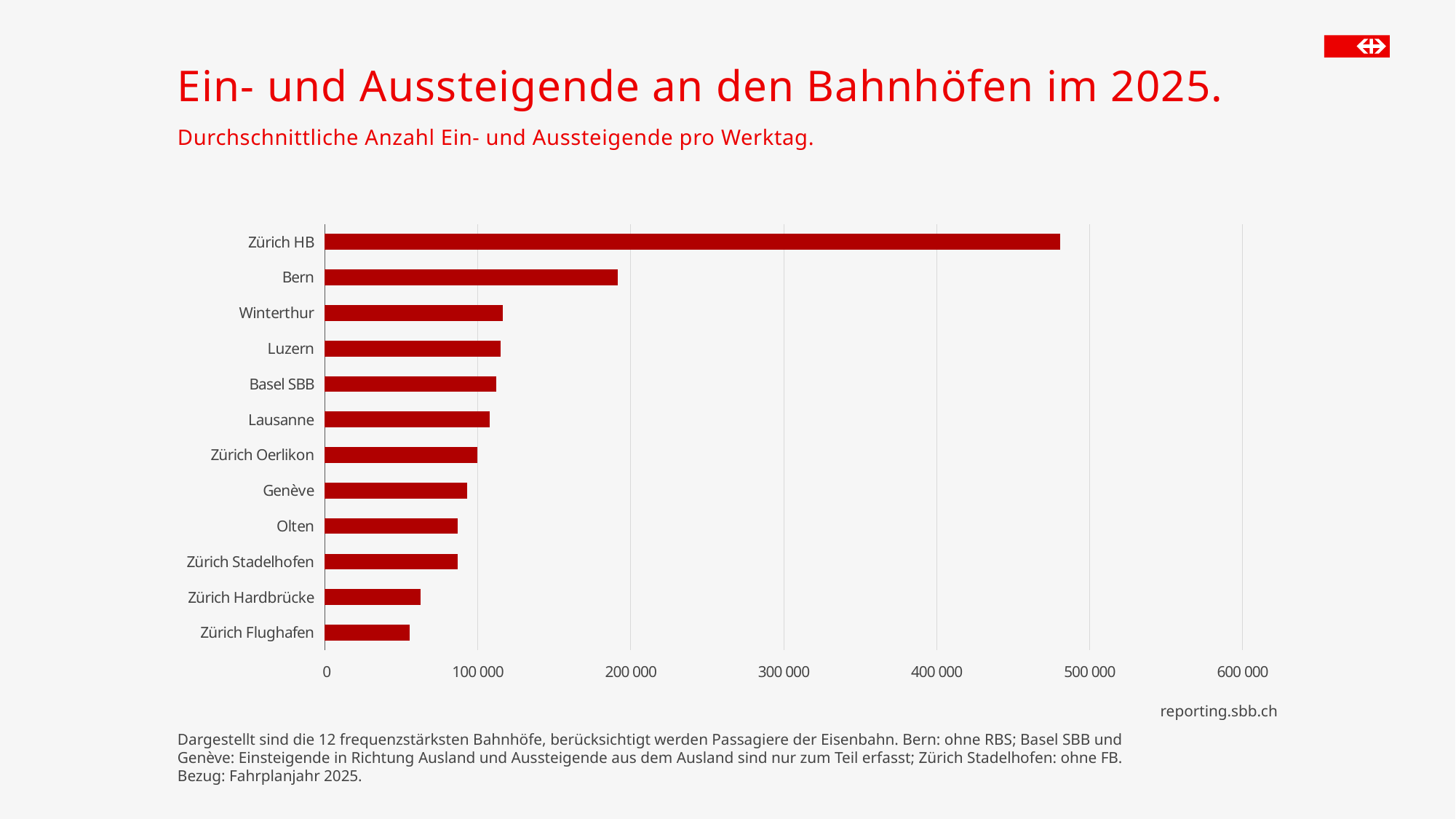
What is the title of the slide? Ein- und Aussteigende an den Bahnhöfen im 2025. Is the value for Bern greater or less than 200 000? less Which station has the highest number of passengers boarding and alighting? Zürich HB Is the value for Zürich Hardbrücke greater or less than 100 000? less Is the value for Zürich HB greater or less than 400 000? greater Which has a higher value, Genève or Zürich Hardbrücke? Genève Which station has the lowest number of passengers boarding and alighting? Zürich Flughafen How many stations are shown in the chart? 12 Which has a higher value, Bern or Winterthur? Bern What kind of chart is shown on the slide? Bar chart